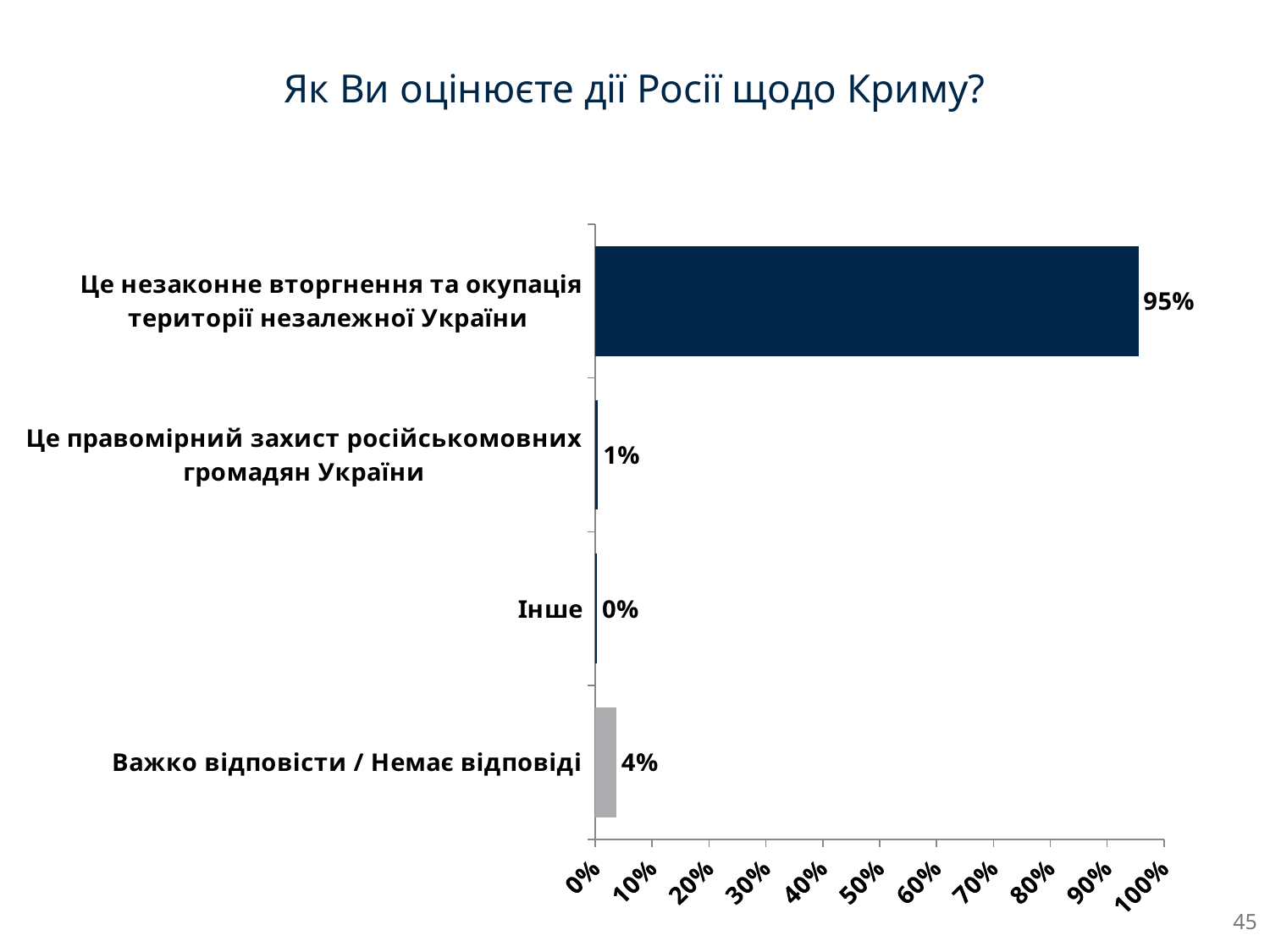
What is the value for "Важко відповісти / Немає відповіді"? 4% How many categories are shown in the chart? 4 Which is larger: the value for "Важко відповісти / Немає відповіді" or the value for "Це правомірний захист російськомовних громадян України"? Важко відповісти / Немає відповіді Which category has the highest value? Це незаконне вторгнення та окупація території незалежної України What is the value for "Інше"? 0% What is the value for "Це правомірний захист російськомовних громадян України"? 1% What is the value for "Це незаконне вторгнення та окупація території незалежної України"? 95% What is the difference between the values for "Це незаконне вторгнення та окупація території незалежної України" and "Важко відповісти / Немає відповіді"? 91% Which category has the lowest value? Інше What is the title of the slide? Як Ви оцінюєте дії Росії щодо Криму? What kind of chart is shown on the slide? bar chart Is the value for "Це незаконне вторгнення та окупація території незалежної України" greater or less than 90%? greater